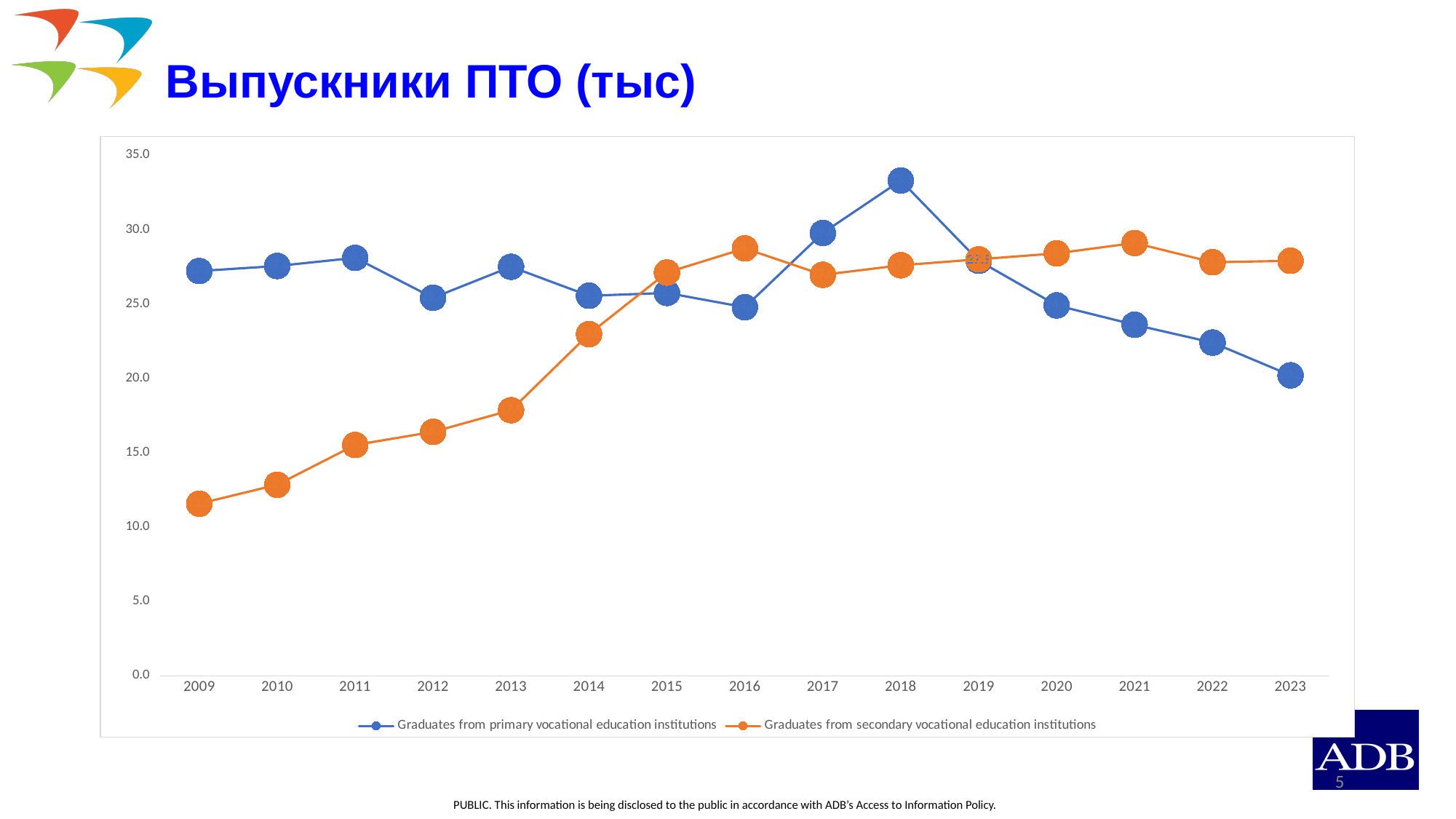
Do the values for graduates from secondary vocational education institutions generally rise or fall from 2009 to 2016? rise What kind of chart is shown on the slide? line chart In which year do graduates from secondary vocational education institutions have their lowest value? 2009 In 2009, which series is larger: graduates from primary or from secondary vocational education institutions? Graduates from primary vocational education institutions In which year do graduates from primary vocational education institutions reach their highest value? 2018 Is the value for graduates from secondary vocational education institutions in 2009 greater or less than 15.0? less How many years are plotted along the x axis? 15 Is the value for graduates from primary vocational education institutions in 2018 greater or less than 30.0? greater What is the title of the slide? Выпускники ПТО (тыс) How many series does the legend list? 2 In which year do graduates from primary vocational education institutions have their lowest value? 2023 In 2023, which series is larger: graduates from primary or from secondary vocational education institutions? Graduates from secondary vocational education institutions